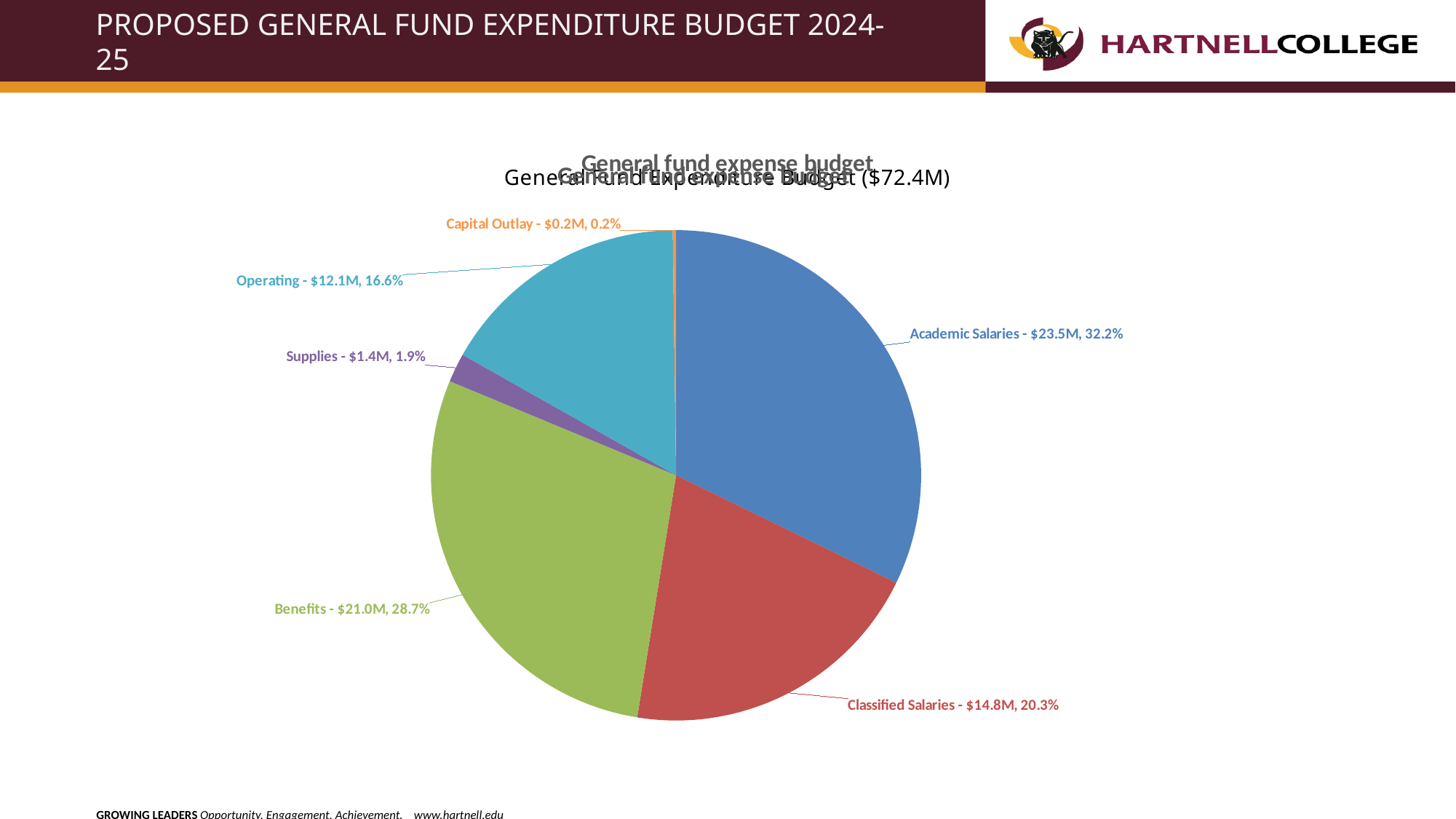
What is the value for Classified Salaries? $14.8M What percentage of the budget is Operating? 16.6% Which category has the largest slice of the pie? Academic Salaries Which is larger, Benefits or Classified Salaries? Benefits How many slices does the pie chart have? 6 What kind of chart is shown on the slide? pie chart What is the value for Academic Salaries? $23.5M What share of the pie is Capital Outlay? 0.2% What is the difference in value between Academic Salaries and Classified Salaries? $8.7M What share of the pie is Benefits? 28.7% What is the value for Supplies? $1.4M Which category has the smallest slice of the pie? Capital Outlay